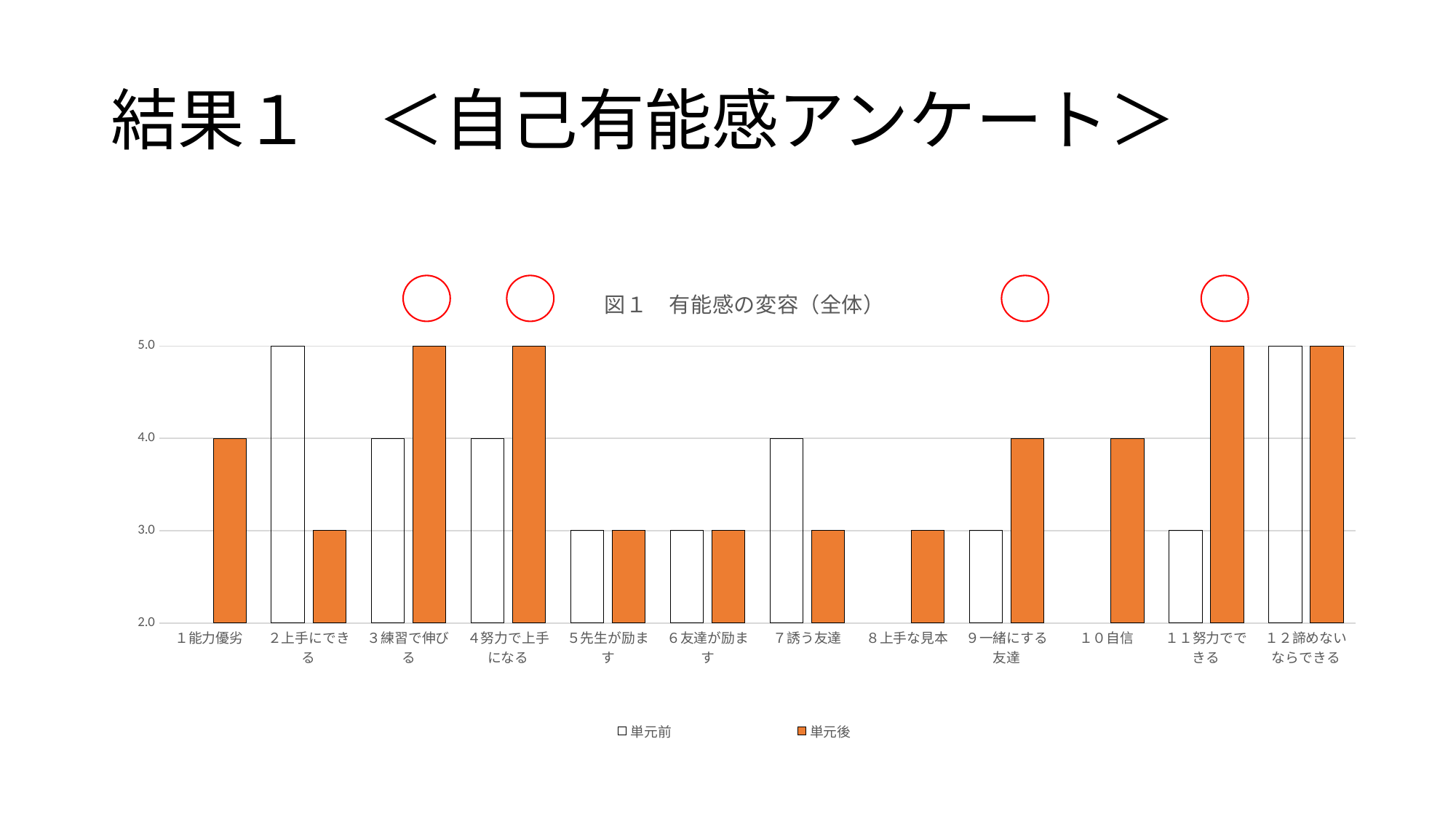
How many series does the legend list? 2 What is the 単元前 value for ２上手にできる? 5.0 What is the difference between the 単元後 and 単元前 values for １１努力でできる? 2.0 Is the 単元後 value for ４努力で上手になる greater or less than 4.0? greater What is the 単元前 value for １１努力でできる? 3.0 How many categories are shown on the x axis? 12 What is the title of the chart? 図１ 有能感の変容（全体） Which is larger for ７誘う友達, the 単元前 value or the 単元後 value? 単元前 Which colour represents the 単元後 series? orange What is the 単元後 value for ９一緒にする友達? 4.0 What kind of chart is shown on the slide? bar chart What is the 単元後 value for ３練習で伸びる? 5.0